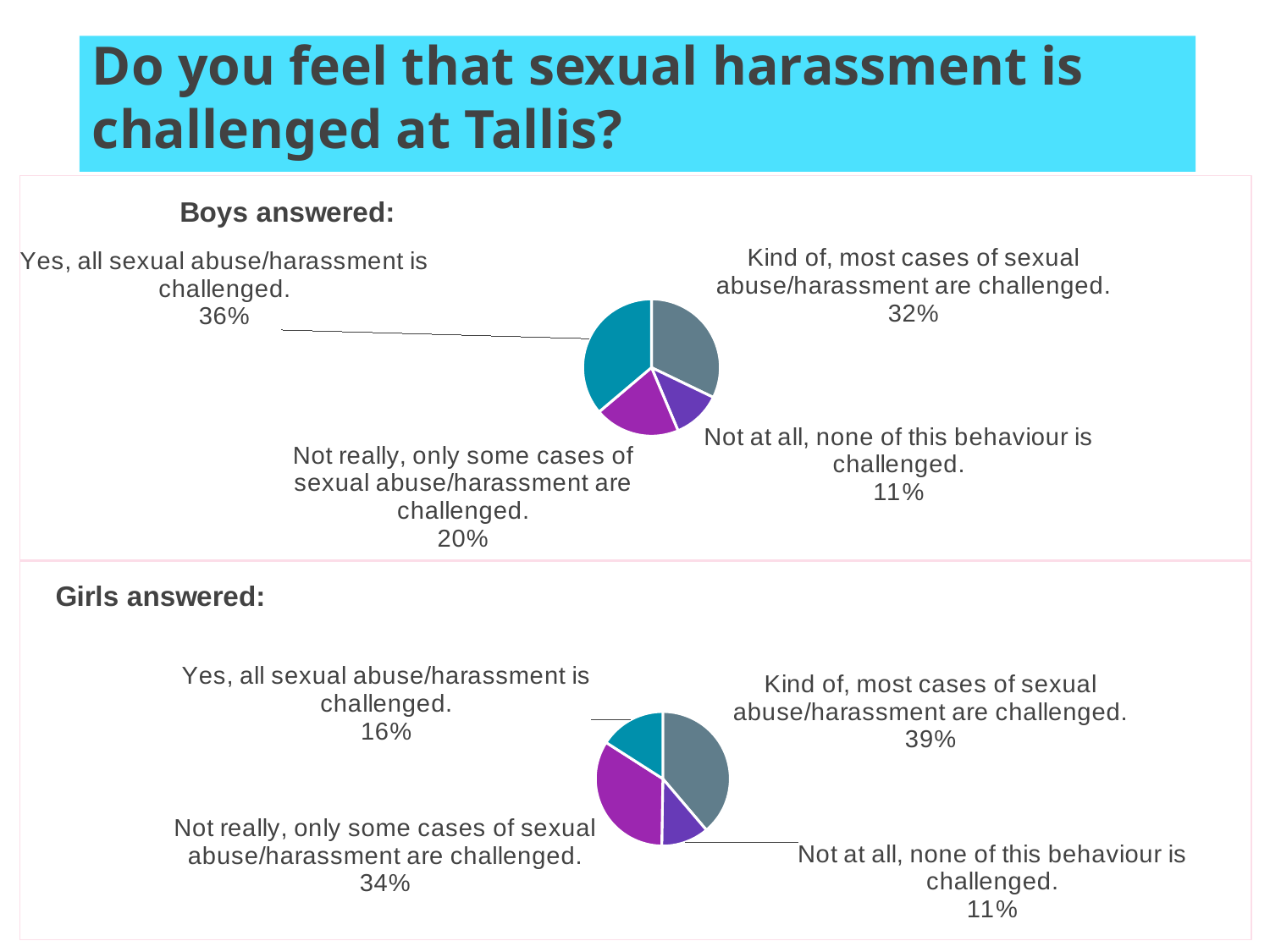
In the 'Boys answered' pie chart, what is the difference between the 'Kind of' share and the 'Not at all' share? 21% In the 'Boys answered' pie chart, which response has the largest share? Yes, all sexual abuse/harassment is challenged. How many pie charts are shown on the slide? 2 In the 'Girls answered' pie chart, what percentage answered 'Kind of, most cases of sexual abuse/harassment are challenged'? 39% In the 'Girls answered' pie chart, what is the difference between the 'Not really, only some cases' share and the 'Yes, all' share? 18% How many slices does the 'Girls answered' pie chart have? 4 What type of chart is used for the 'Boys answered' data? Pie chart In the 'Boys answered' pie chart, what percentage answered 'Yes, all sexual abuse/harassment is challenged'? 36% Which is larger: the 'Not really, only some cases' share for boys or for girls? Girls In the 'Boys answered' pie chart, which is larger: 'Yes, all sexual abuse/harassment is challenged' or 'Kind of, most cases are challenged'? Yes, all sexual abuse/harassment is challenged. In the 'Girls answered' pie chart, which response has the smallest share? Not at all, none of this behaviour is challenged. In the 'Girls answered' pie chart, what share of the pie is 'Not at all, none of this behaviour is challenged'? 11%